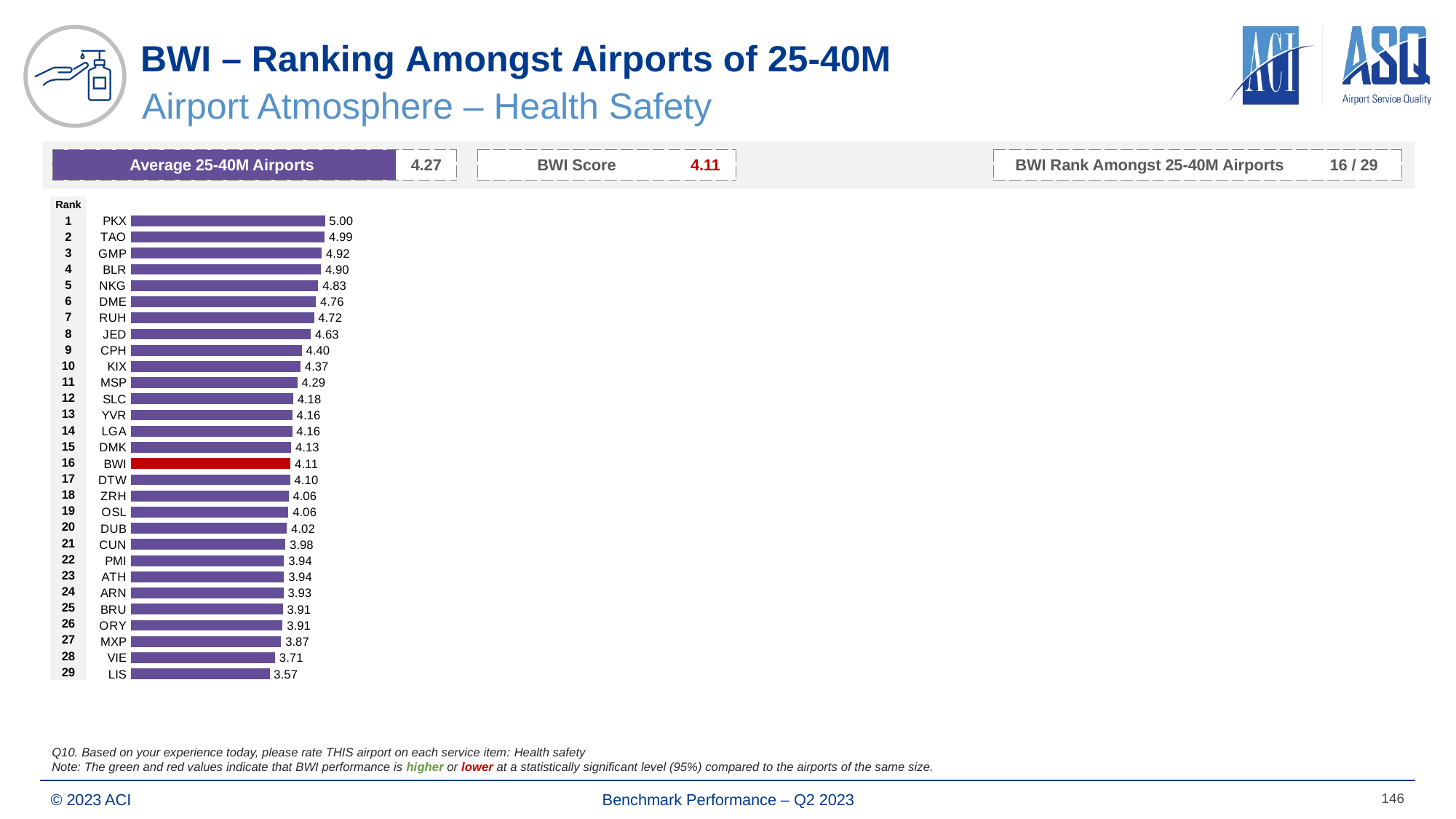
What is the value for CPH? 4.40 What is the value for VIE? 3.71 What is the difference between the values for BWI and DTW? 0.01 What is the value for BWI? 4.11 Which has a larger value, JED or MSP? JED How many airports are shown in the chart? 29 What kind of chart is shown on the slide? Bar chart What rank does BWI hold in the chart? 16 Which airport has the lowest value? LIS Which bar in the chart is coloured red? BWI What is the difference between the values for PKX and LIS? 1.43 Which airport has the highest value? PKX